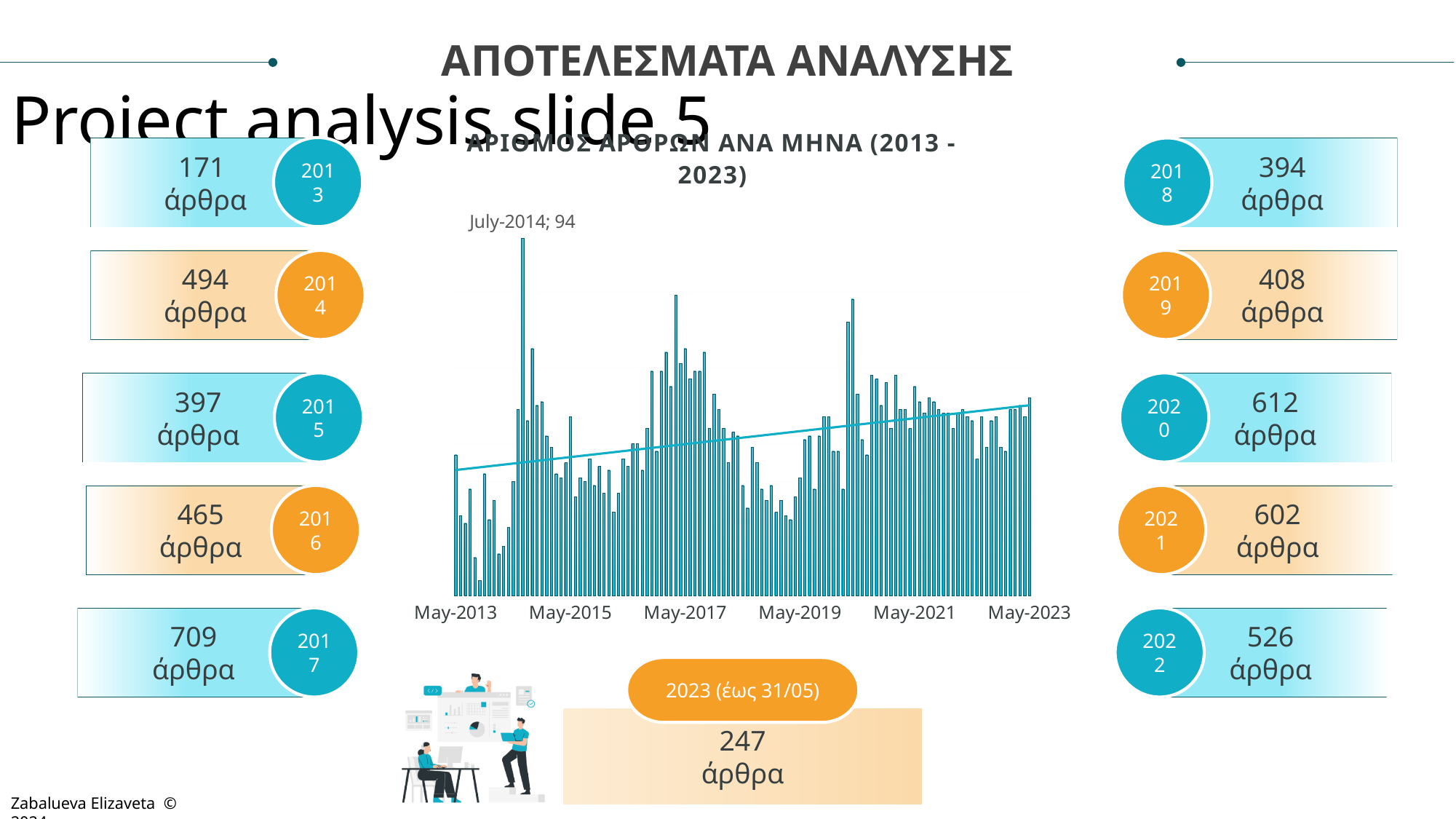
Which month has the highest bar in the chart? July-2014 How many tick labels are shown on the x axis of the chart? 6 Does the trend line in the chart rise or fall from May-2013 to May-2023? rise What is the title of the chart? ΑΡΙΘΜΟΣ ΑΡΘΡΩΝ ΑΝΑ ΜΗΝΑ (2013 - 2023) What value is shown by the data label for July-2014? 94 What kind of chart is shown on the slide? bar chart What is the first label on the x axis of the chart? May-2013 What is the last label on the x axis of the chart? May-2023 Is the tallest bar in the chart located before or after May-2015? before What is the only data label printed on the chart? July-2014; 94